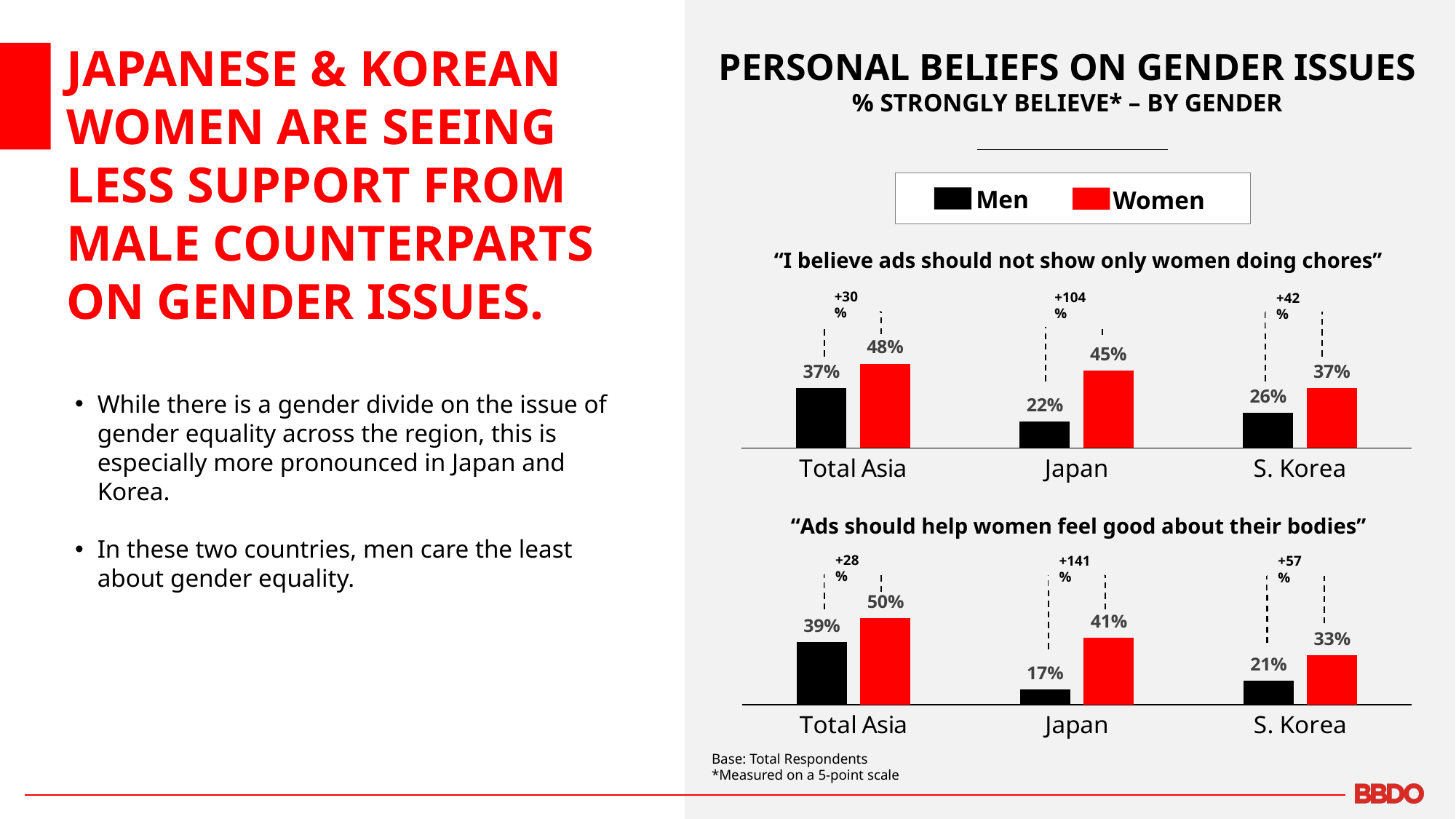
In the chart "Ads should help women feel good about their bodies", what is the value for Women in Total Asia? 50% In the chart "Ads should help women feel good about their bodies", which is larger: the Men value for Total Asia or the Women value for S. Korea? Men value for Total Asia What type of chart is used for "Ads should help women feel good about their bodies"? Bar chart In the chart "I believe ads should not show only women doing chores", what is the difference between the Women and Men values for Japan? 23 percentage points In the chart "Ads should help women feel good about their bodies", which country or region has the highest value for Women? Total Asia In the chart "I believe ads should not show only women doing chores", what is the value for Men in S. Korea? 26% How many series does the legend list for the charts on this slide? 2 In the chart "Ads should help women feel good about their bodies", what is the difference between the Women and Men values for S. Korea? 12 percentage points How many countries or regions are shown on the x axis of the chart "I believe ads should not show only women doing chores"? 3 In the chart "I believe ads should not show only women doing chores", what is the value for Women in Japan? 45% In the chart "I believe ads should not show only women doing chores", which country or region has the lowest value for Men? Japan In the chart "Ads should help women feel good about their bodies", what is the value for Men in Japan? 17%